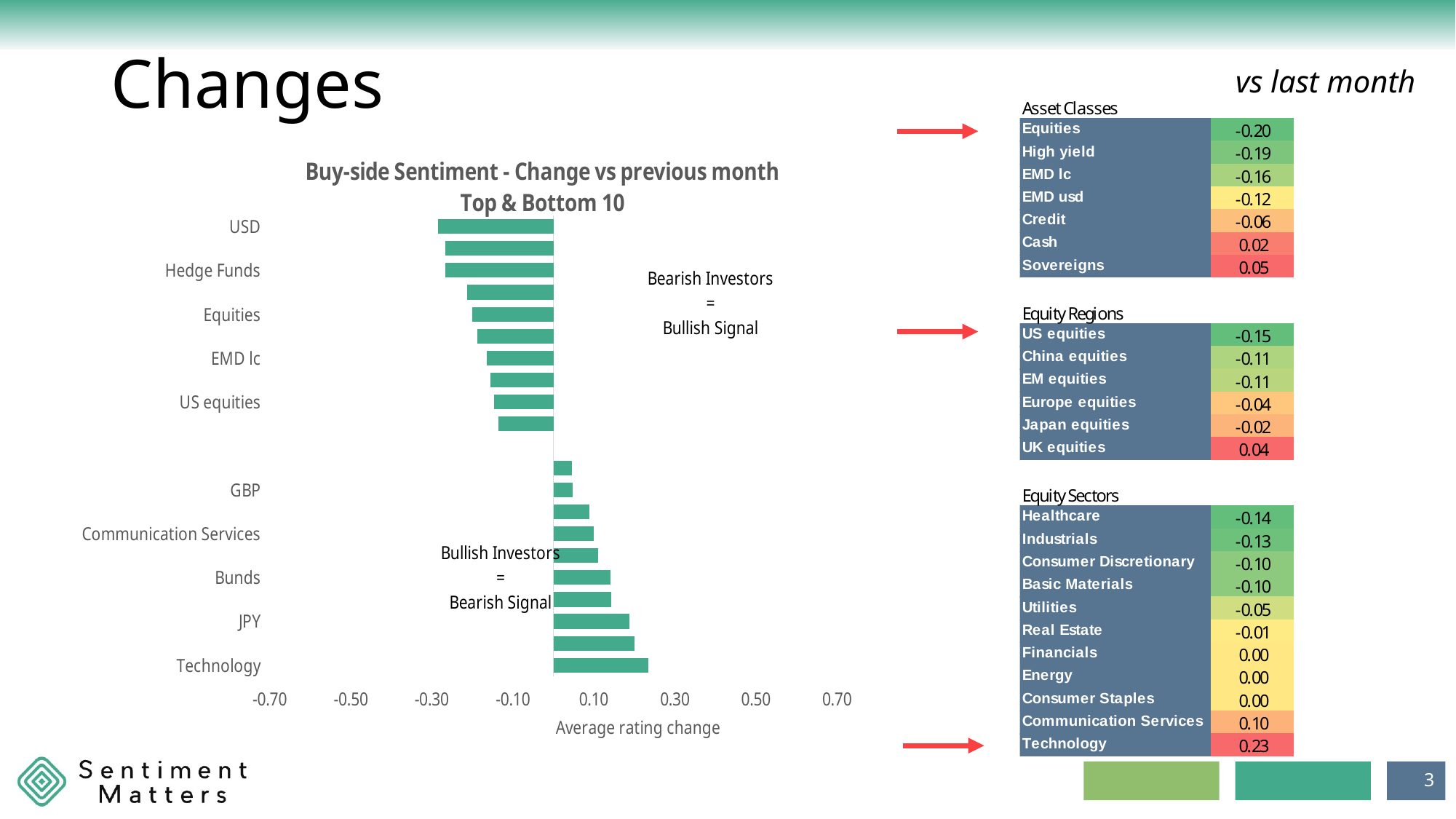
Is the value for USD greater or less than -0.10? less Which has the larger average rating change, USD or Equities? Equities Is the value for GBP greater or less than 0.10? less Which labelled category has the highest average rating change in the chart? Technology What is the label of the horizontal axis of the chart? Average rating change Which labelled category has the lowest average rating change in the chart? USD How many bars are plotted in the chart? 20 What is the title of the chart? Buy-side Sentiment - Change vs previous month Top & Bottom 10 What kind of chart is shown on the slide? bar chart Which has the larger average rating change, Technology or JPY? Technology Is the value for Hedge Funds greater or less than -0.10? less